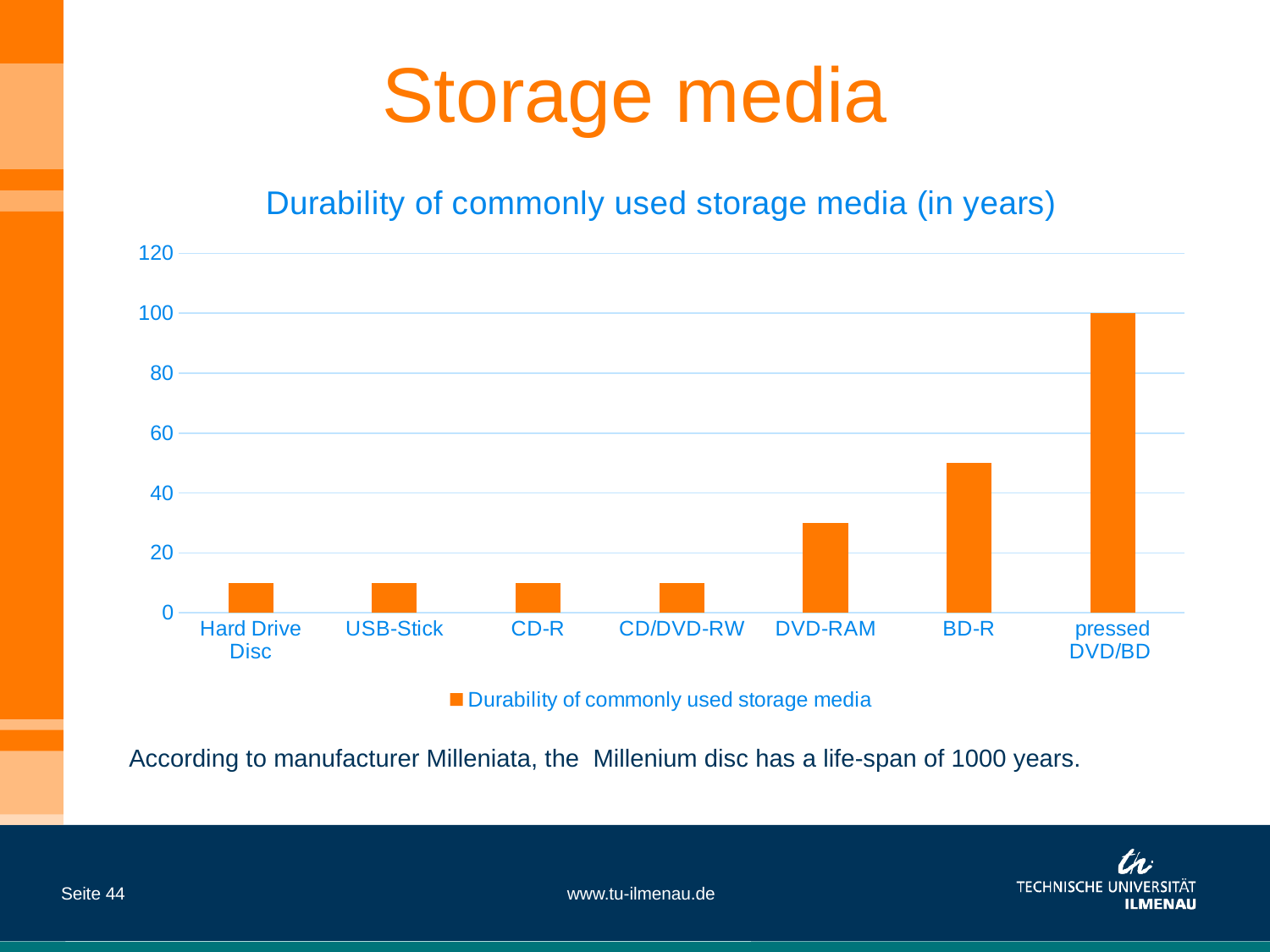
How many storage media categories are shown on the x axis? 7 What is the value for pressed DVD/BD? 100 What kind of chart is shown on the slide? bar chart Do the values rise or fall from left to right along the x axis? rise Is the value for DVD-RAM greater or less than 20? greater Is the value for BD-R greater or less than 60? less What is the title of the chart? Durability of commonly used storage media (in years) Which storage medium has the highest durability in the chart? pressed DVD/BD Which has a larger value, BD-R or DVD-RAM? BD-R How many series does the legend list? 1 Is the value for BD-R greater or less than 40? greater